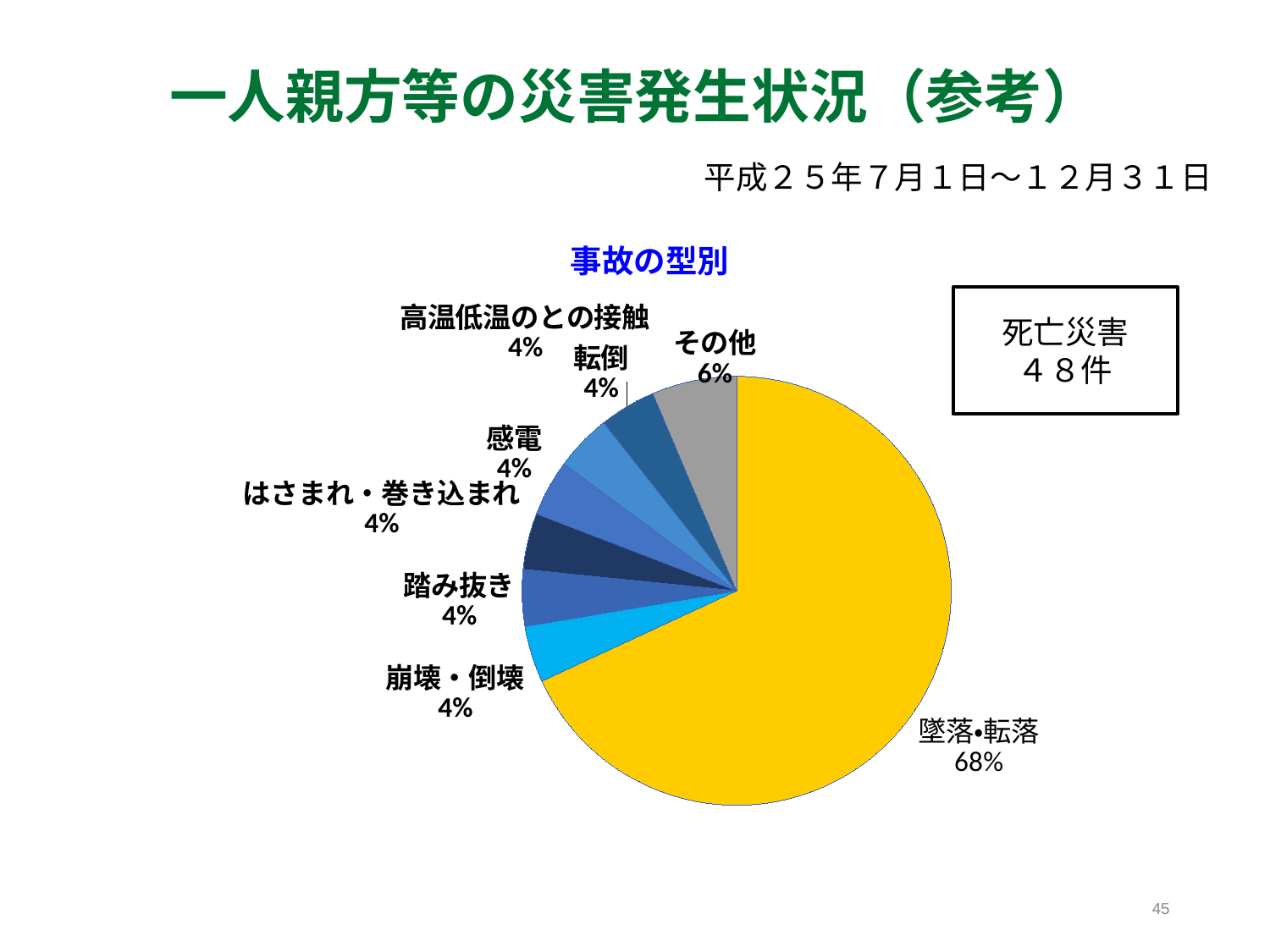
What share of the pie does 墜落•転落 account for? 68% Which category has the largest slice of the pie? 墜落•転落 How many categories are shown in the pie chart? 8 What kind of chart is shown on the slide? pie chart What share of the pie does 崩壊・倒壊 account for? 4% What is the difference in percentage points between 墜落•転落 and その他? 62 What share of the pie does 感電 account for? 4% Which is larger, the slice for その他 or the slice for 転倒? その他 What is the difference in percentage points between その他 and 踏み抜き? 2 What share of the pie does その他 account for? 6% What is the title of the chart? 事故の型別 What colour is the slice for 墜落•転落? yellow